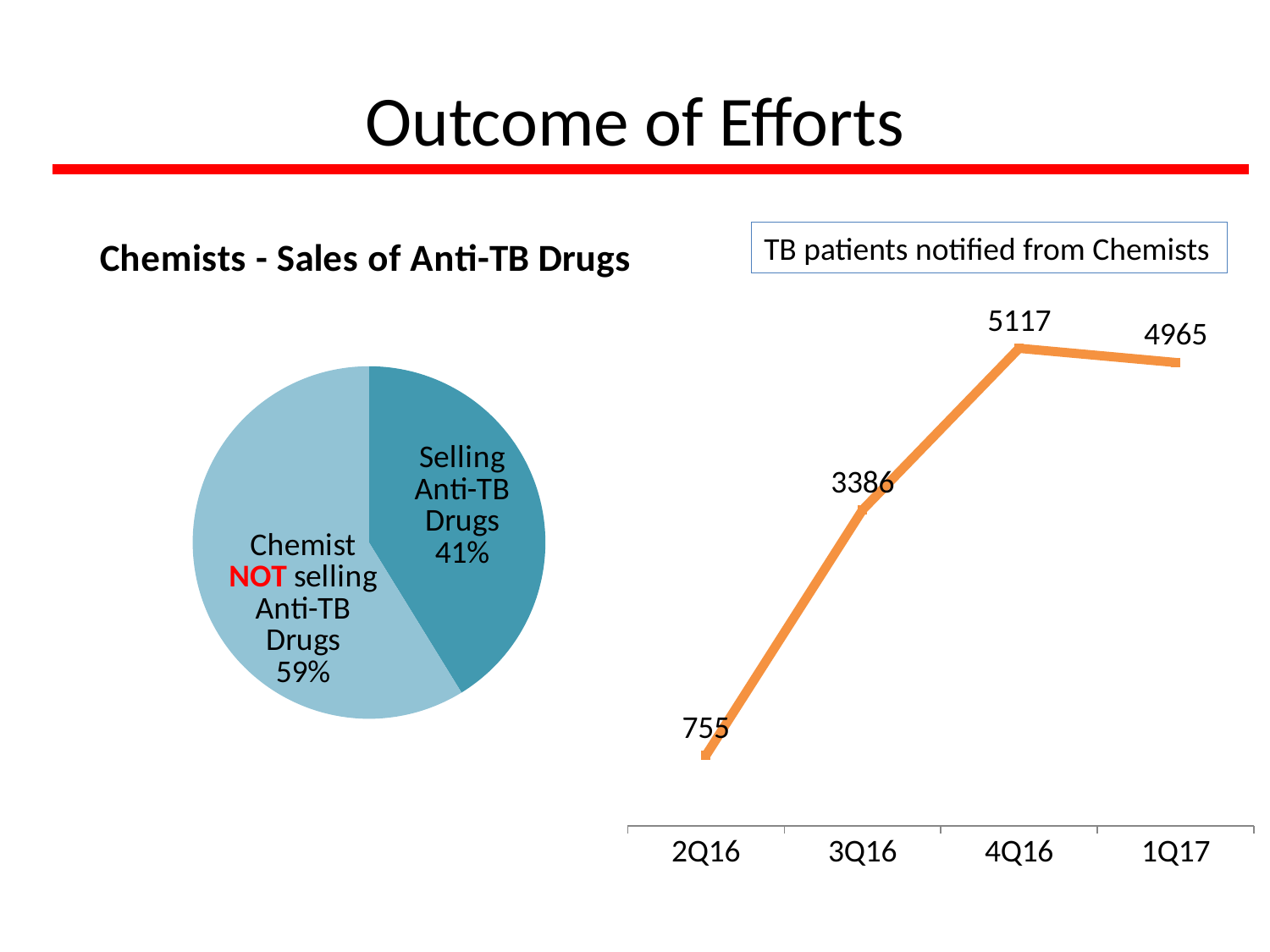
In the 'TB patients notified from Chemists' chart, which quarter has the lowest value? 2Q16 In the 'TB patients notified from Chemists' chart, what is the value for 1Q17? 4965 In the 'Chemists - Sales of Anti-TB Drugs' chart, what share of chemists are selling Anti-TB drugs? 41% In the 'TB patients notified from Chemists' chart, which quarter has the highest value? 4Q16 How many slices does the 'Chemists - Sales of Anti-TB Drugs' pie chart have? 2 In the 'Chemists - Sales of Anti-TB Drugs' chart, which slice is larger: chemists selling or chemists NOT selling Anti-TB drugs? Chemist NOT selling Anti-TB Drugs In the 'Chemists - Sales of Anti-TB Drugs' chart, what share of chemists are NOT selling Anti-TB drugs? 59% In the 'TB patients notified from Chemists' chart, what is the difference between the values for 4Q16 and 1Q17? 152 What kind of chart is 'TB patients notified from Chemists'? Line chart In the 'TB patients notified from Chemists' chart, what is the value for 3Q16? 3386 In the 'TB patients notified from Chemists' chart, what is the value for 2Q16? 755 What kind of chart is 'Chemists - Sales of Anti-TB Drugs'? Pie chart